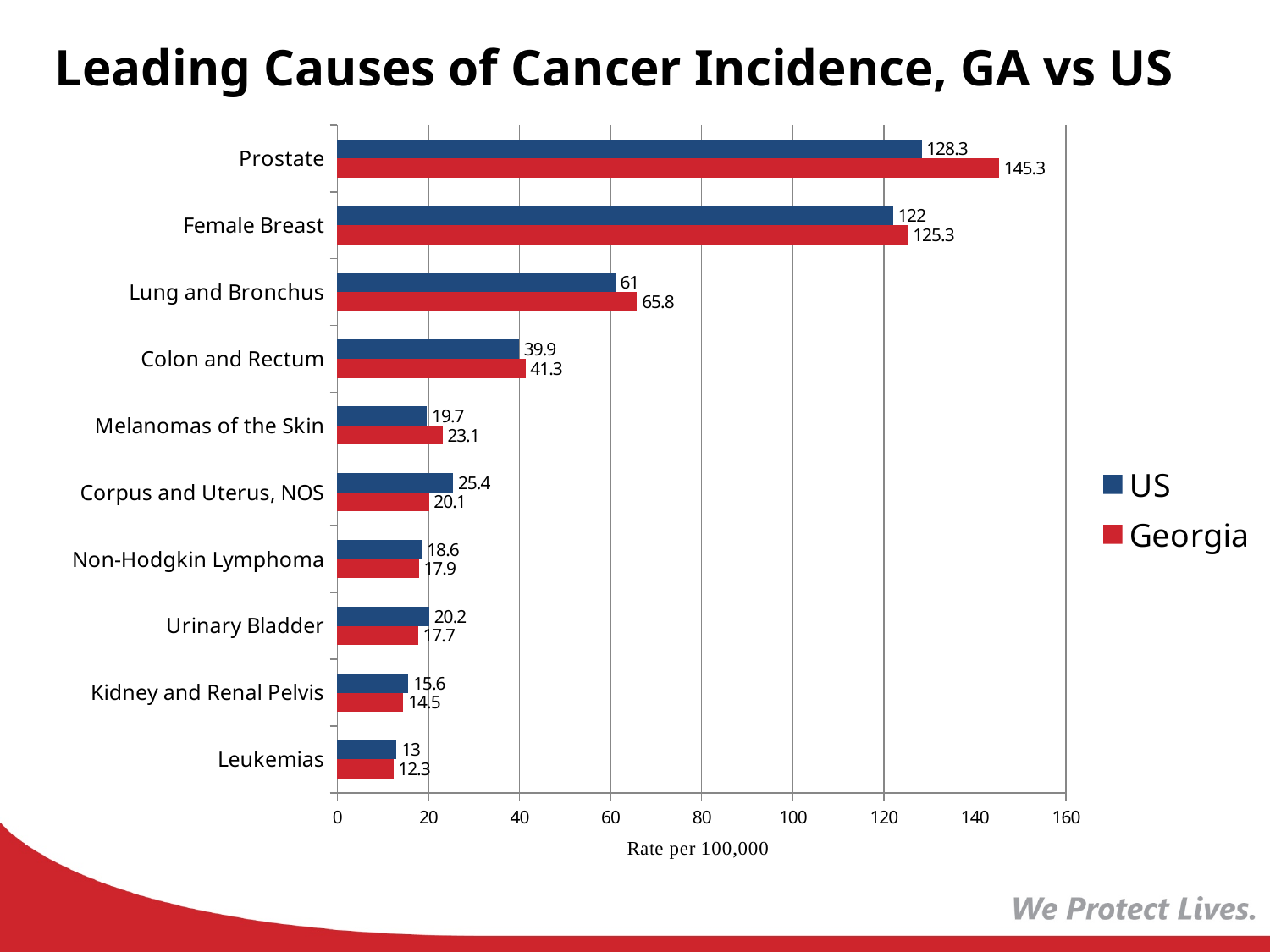
Which cancer type has the lowest US rate? Leukemias How many cancer types are shown on the chart? 10 Is the Georgia rate for Female Breast cancer greater or less than 120? greater What is the US rate for Lung and Bronchus cancer? 61 Which cancer type has the highest Georgia rate? Prostate How many series does the legend list? 2 What is the label of the horizontal axis? Rate per 100,000 What is the Georgia rate for Melanomas of the Skin? 23.1 What is the difference between the Georgia and US rates for Prostate cancer? 17 Which is larger for Corpus and Uterus, NOS: the US rate or the Georgia rate? US What kind of chart is shown on the slide? Bar chart What is the Georgia rate for Prostate cancer? 145.3